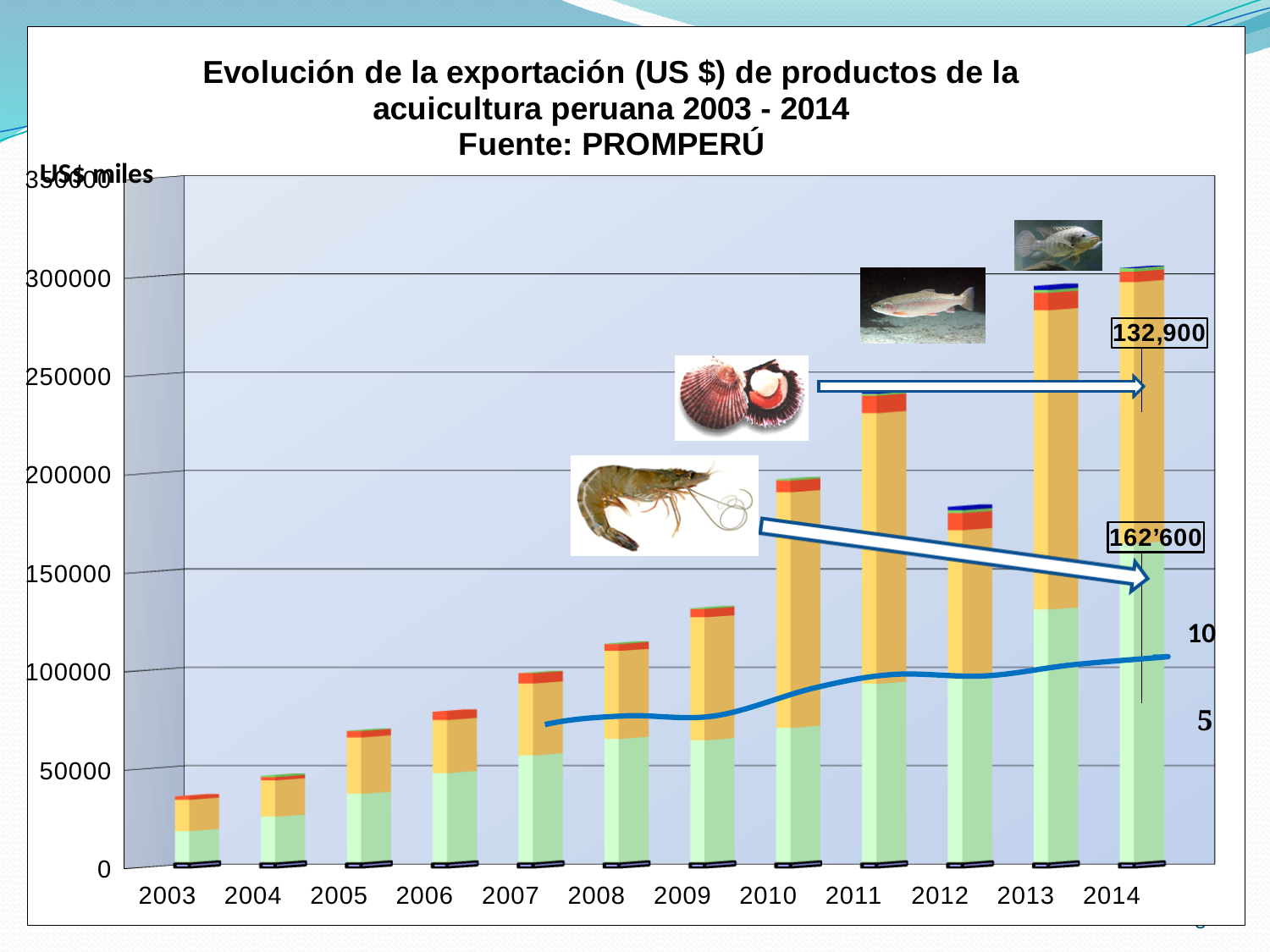
Which year has the shortest bar in the chart? 2003 Is the total bar value for 2003 greater or less than 50000? less According to the chart title, what is the source (Fuente) of the data? PROMPERÚ Do the bar heights generally rise or fall from 2003 to 2014? Rise How many years are shown along the x axis of the chart? 12 Is the total bar value for 2012 greater or less than 150000? greater What value is shown in the label at the end of the arrow coming from the scallop image? 132,900 What kind of chart is shown on the slide? Stacked bar chart Is the total bar value for 2011 greater or less than 250000? less Which year has the taller bar, 2011 or 2012? 2011 Which year has the tallest bar in the chart? 2014